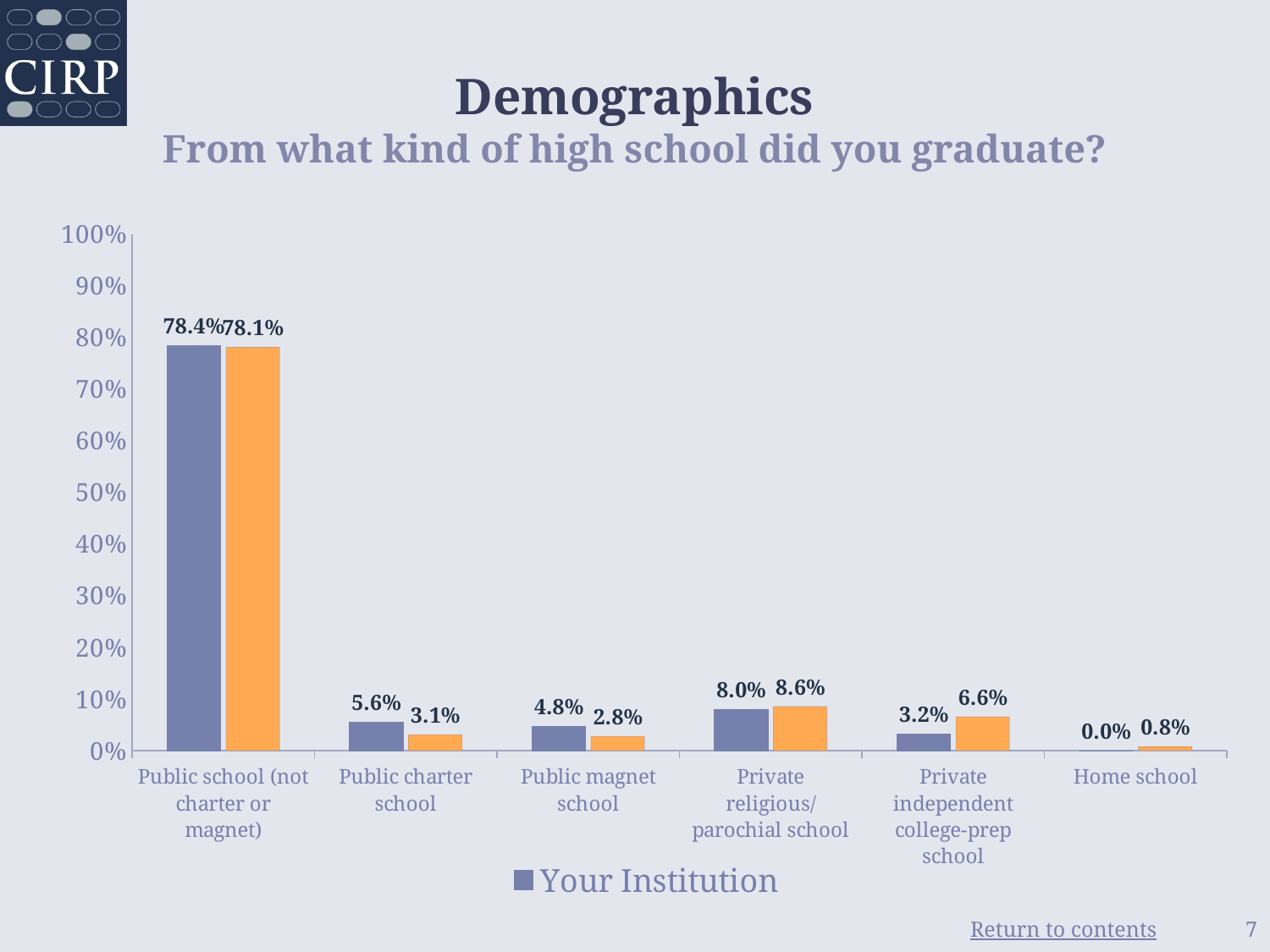
How many series does the legend list? 1 What is the value for Your Institution for Public school (not charter or magnet)? 78.4% Which category has the highest value for Your Institution? Public school (not charter or magnet) What kind of chart is shown on the slide? bar chart Which category has the lowest value for Your Institution? Home school What value is printed on the orange bar for Private independent college-prep school? 6.6% Is the Your Institution value for Public school (not charter or magnet) greater or less than 70%? greater What is the value for Your Institution for Private religious/parochial school? 8.0% What is the value for Your Institution for Home school? 0.0% For Your Institution, which is larger: Public charter school or Private religious/parochial school? Private religious/parochial school How many high school categories are shown on the x axis? 6 What is the difference between the Your Institution value for Public school (not charter or magnet) and for Public charter school? 72.8%